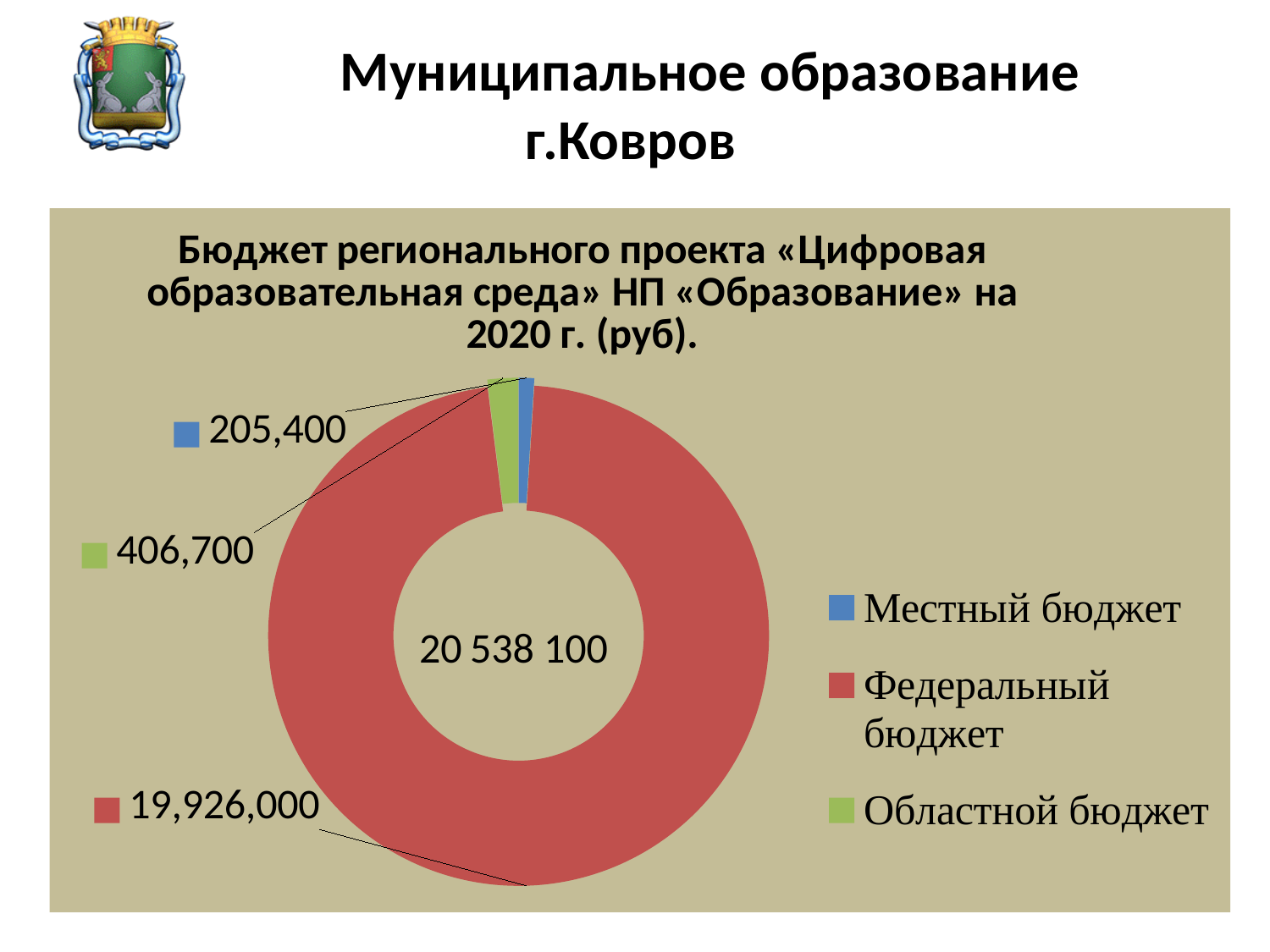
What is the value for Местный бюджет? 205,400 Which budget source has the largest value? Федеральный бюджет What total value is shown in the centre of the chart? 20 538 100 What is the value for Федеральный бюджет? 19,926,000 What is the difference between Областной бюджет and Местный бюджет? 201,300 What is the value for Областной бюджет? 406,700 Which is larger, Областной бюджет or Местный бюджет? Областной бюджет What is the difference between Федеральный бюджет and Областной бюджет? 19,519,300 What kind of chart is shown on the slide? doughnut chart What colour represents Федеральный бюджет in the chart? red Which budget source has the smallest value? Местный бюджет How many categories does the chart show? 3